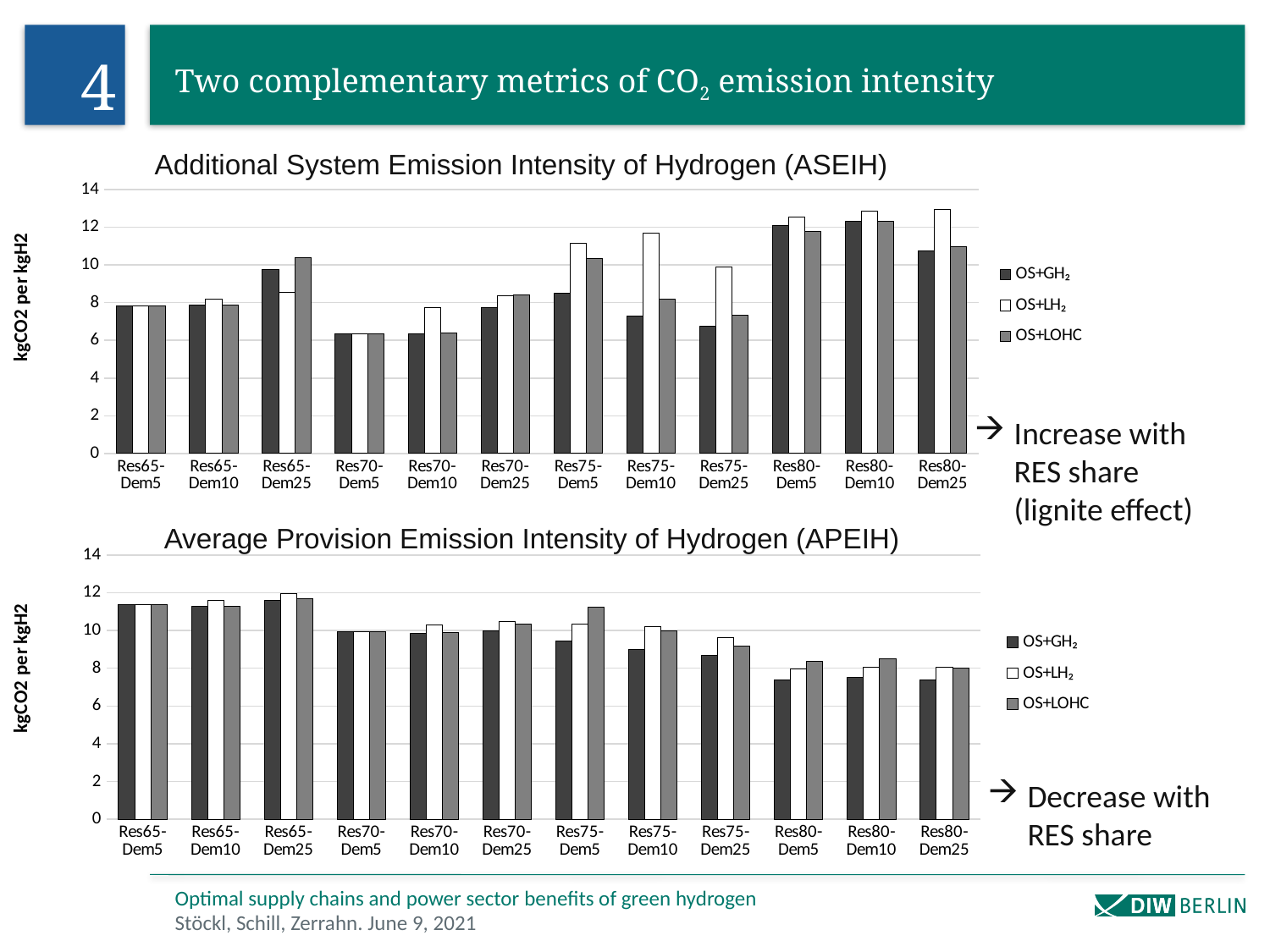
What type of chart is the Additional System Emission Intensity of Hydrogen (ASEIH) chart? bar chart In the ASEIH chart, how many series does the legend list? 3 What is the y-axis label of the ASEIH chart? kgCO2 per kgH2 In the APEIH chart, for Res75-Dem5, which series has the larger value: OS+GH2 or OS+LOHC? OS+LOHC In the APEIH chart, is the OS+GH2 value for Res80-Dem25 greater or less than 8? less In the Average Provision Emission Intensity of Hydrogen (APEIH) chart, how many categories are shown on the x axis? 12 In the APEIH chart, do the OS+GH2 values generally rise or fall from Res65-Dem5 to Res80-Dem25? fall In the ASEIH chart, is the OS+LH2 value for Res70-Dem5 greater or less than 8? less In the ASEIH chart, how many categories are shown on the x axis? 12 In the ASEIH chart, which category has the lowest OS+LH2 value? Res70-Dem5 In the ASEIH chart, is the OS+GH2 value for Res80-Dem5 greater or less than 10? greater In the ASEIH chart, for Res75-Dem10, which series has the larger value: OS+GH2 or OS+LH2? OS+LH2